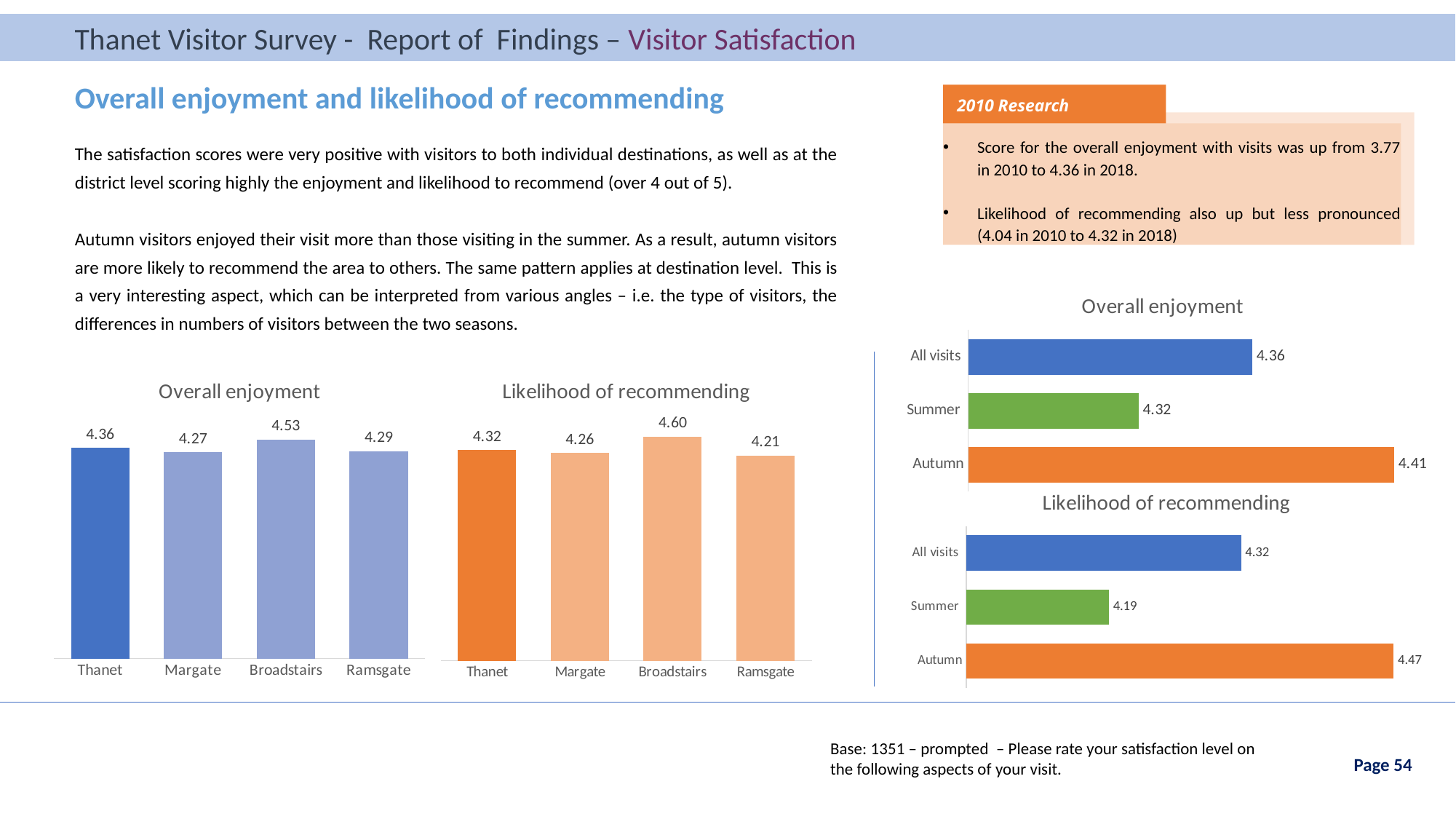
In the 'Likelihood of recommending' chart by destination (bottom middle), which destination has the highest score? Broadstairs In the bottom-left 'Overall enjoyment' chart by destination, what is the difference between Broadstairs and Margate? 0.26 In the 'Overall enjoyment' chart by season on the right, which is larger, Summer or Autumn? Autumn In the bottom-left 'Overall enjoyment' chart by destination, which destination has the lowest score? Margate In the 'Likelihood of recommending' chart by destination (bottom middle), what is the value for Ramsgate? 4.21 In the 'Overall enjoyment' chart by season on the right, what is the value for Autumn? 4.41 In the bottom-left 'Overall enjoyment' chart by destination, what is the value for Broadstairs? 4.53 In the 'Likelihood of recommending' chart by season on the right, what colour is the Summer bar? Green In the 'Likelihood of recommending' chart by season on the right, what is the value for Summer? 4.19 In the 'Likelihood of recommending' chart by season on the right, what is the difference between Autumn and Summer? 0.28 What type of chart is the 'Overall enjoyment' chart by season on the right? Bar chart In the 'Likelihood of recommending' chart by destination (bottom middle), how many destinations are shown? 4